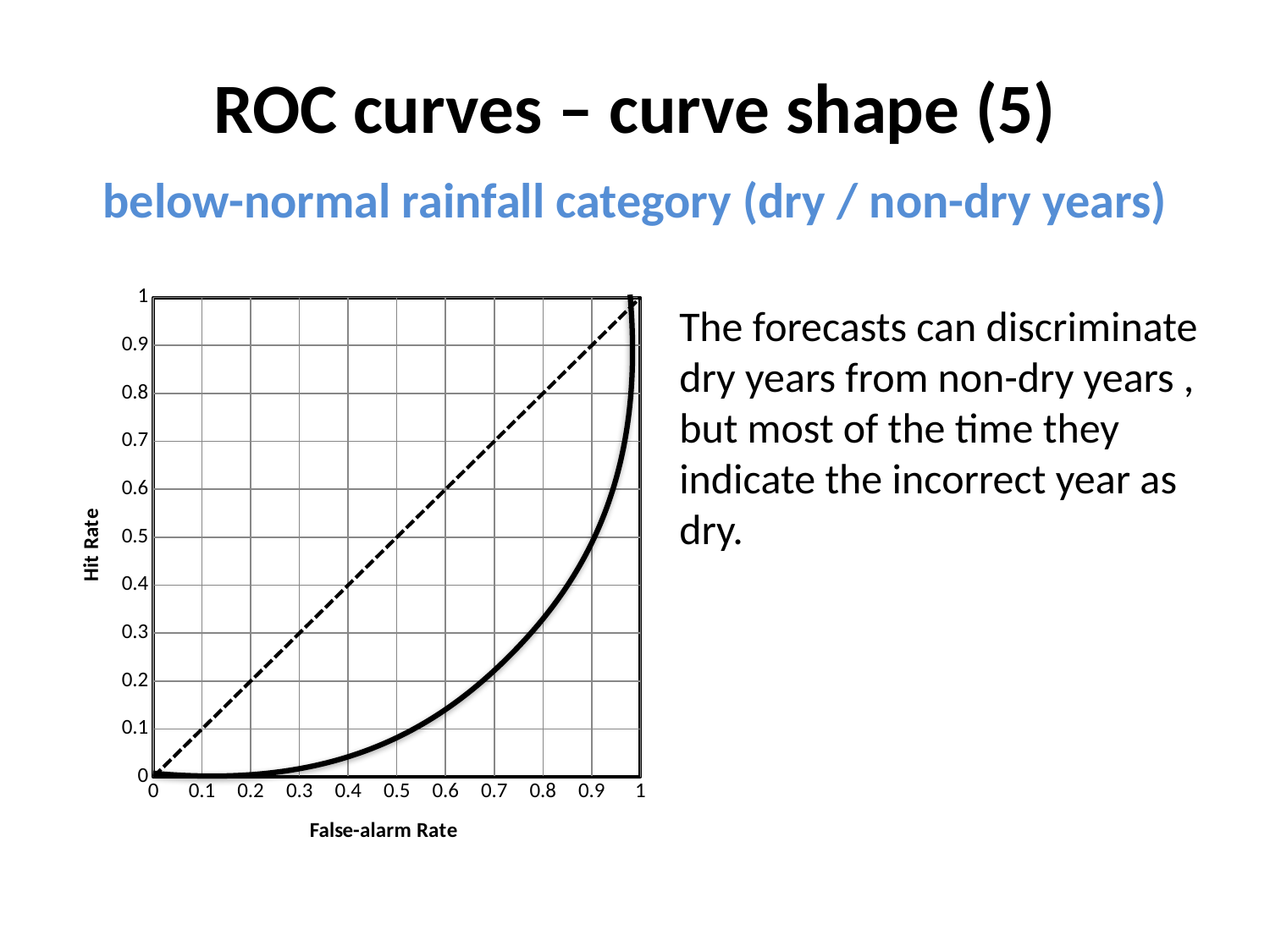
At a false-alarm rate of 0.8, is the hit rate of the solid curve greater or less than 0.5? less What is the hit rate of the solid curve at a false-alarm rate of 0? 0 At a false-alarm rate of 0.5, is the hit rate of the solid curve greater or less than 0.5? less What is the label of the y axis of the chart? Hit Rate What is the hit rate of the solid curve at a false-alarm rate of 1? 1 Does the solid curve rise or fall as the false-alarm rate increases from 0 to 1? rise What kind of chart is shown on the slide? line chart At a false-alarm rate of 0.5, which line has the higher hit rate, the solid curve or the dashed diagonal line? the dashed diagonal line How many lines are plotted on the chart? 2 What is the maximum value shown on the y axis of the chart? 1 What is the label of the x axis of the chart? False-alarm Rate At a false-alarm rate of 0.3, is the hit rate of the solid curve greater or less than 0.1? less